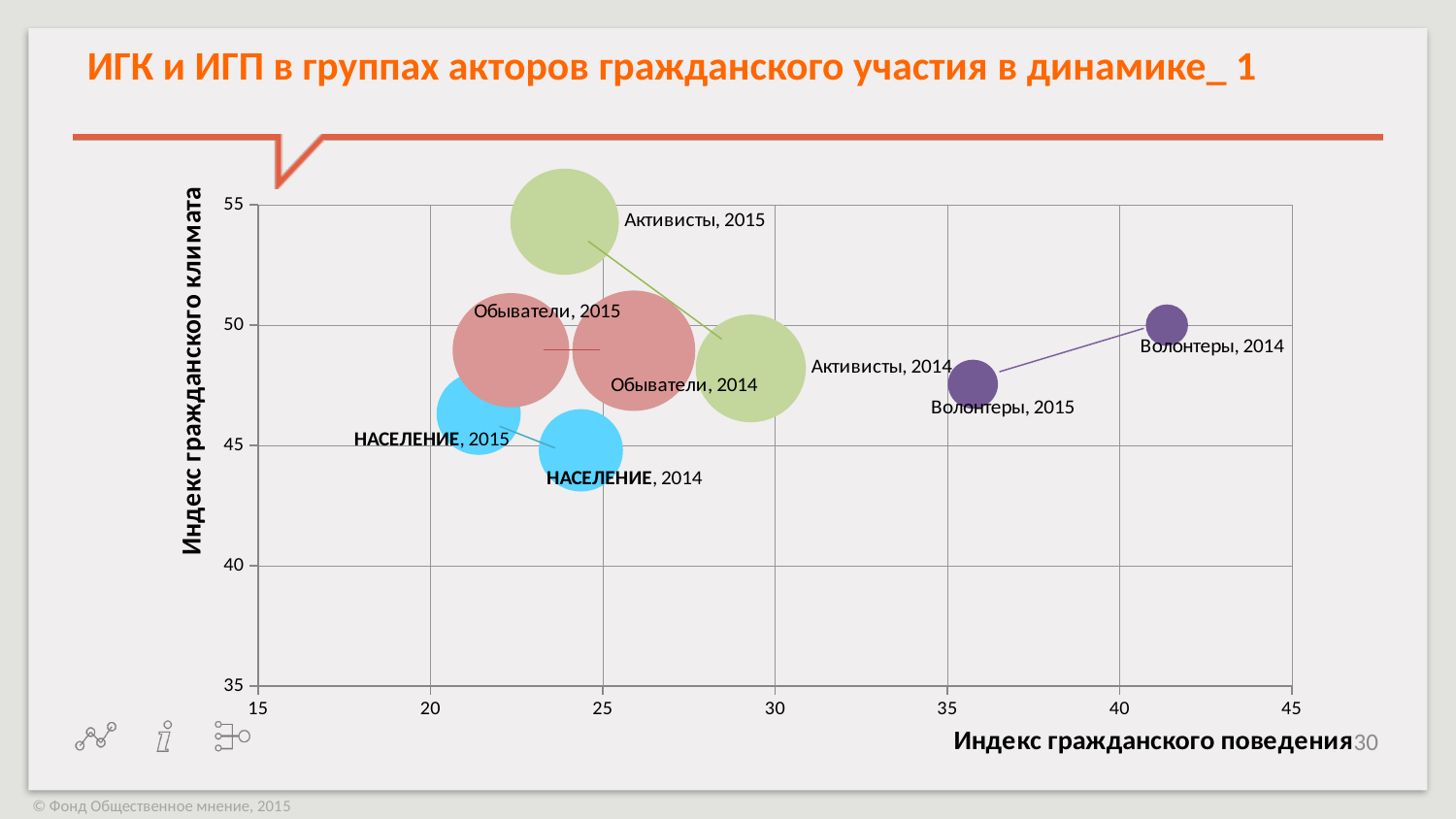
Is the horizontal-axis value for Волонтеры, 2014 greater or less than 40? greater Is the horizontal-axis value for НАСЕЛЕНИЕ, 2015 greater or less than 25? less What is the label of the horizontal axis of the chart? Индекс гражданского поведения Is the vertical-axis value for Активисты, 2015 greater or less than 50? greater Which has the larger vertical-axis value: Активисты, 2015 or Активисты, 2014? Активисты, 2015 How many bubbles (data points) are plotted on the chart? 8 What kind of chart is shown on the slide? bubble chart Which data point has the highest value on the horizontal axis (Индекс гражданского поведения)? Волонтеры, 2014 Which data point has the highest value on the vertical axis (Индекс гражданского климата)? Активисты, 2015 Which has the larger horizontal-axis value: Волонтеры, 2014 or Волонтеры, 2015? Волонтеры, 2014